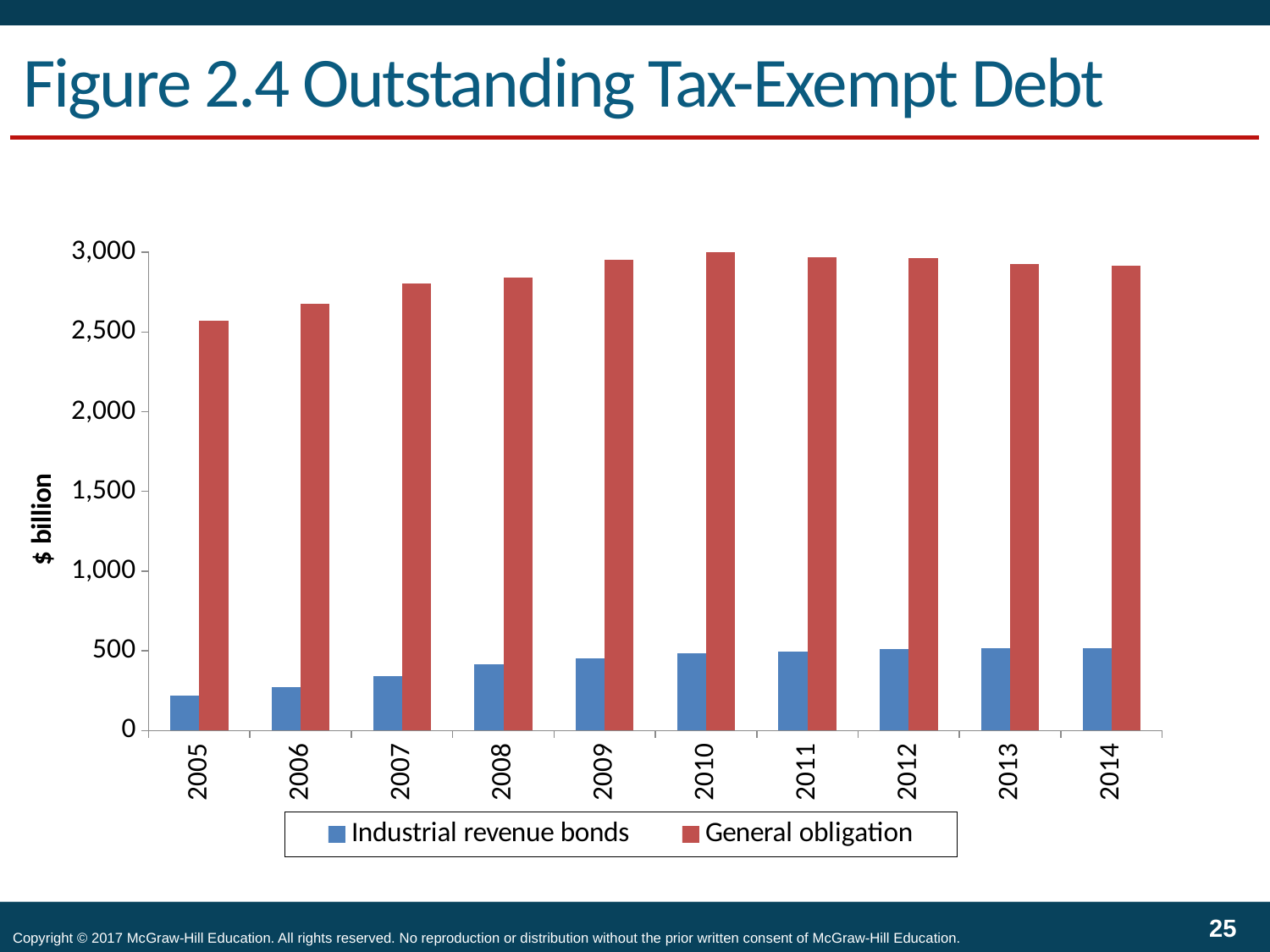
How many series does the legend list? 2 Is the value for Industrial revenue bonds in 2005 greater or less than 500? less Which is larger in 2009, Industrial revenue bonds or General obligation? General obligation Is the value for General obligation in 2010 greater or less than 2,500? greater Which year has the lowest value for Industrial revenue bonds? 2005 Is the value for General obligation in 2005 greater or less than 2,500? greater What is the label on the y axis? $ billion Which year has the lowest value for General obligation? 2005 What kind of chart is shown on the slide? bar chart How many years are shown on the x axis? 10 Do the values for Industrial revenue bonds rise or fall from 2005 to 2014? rise